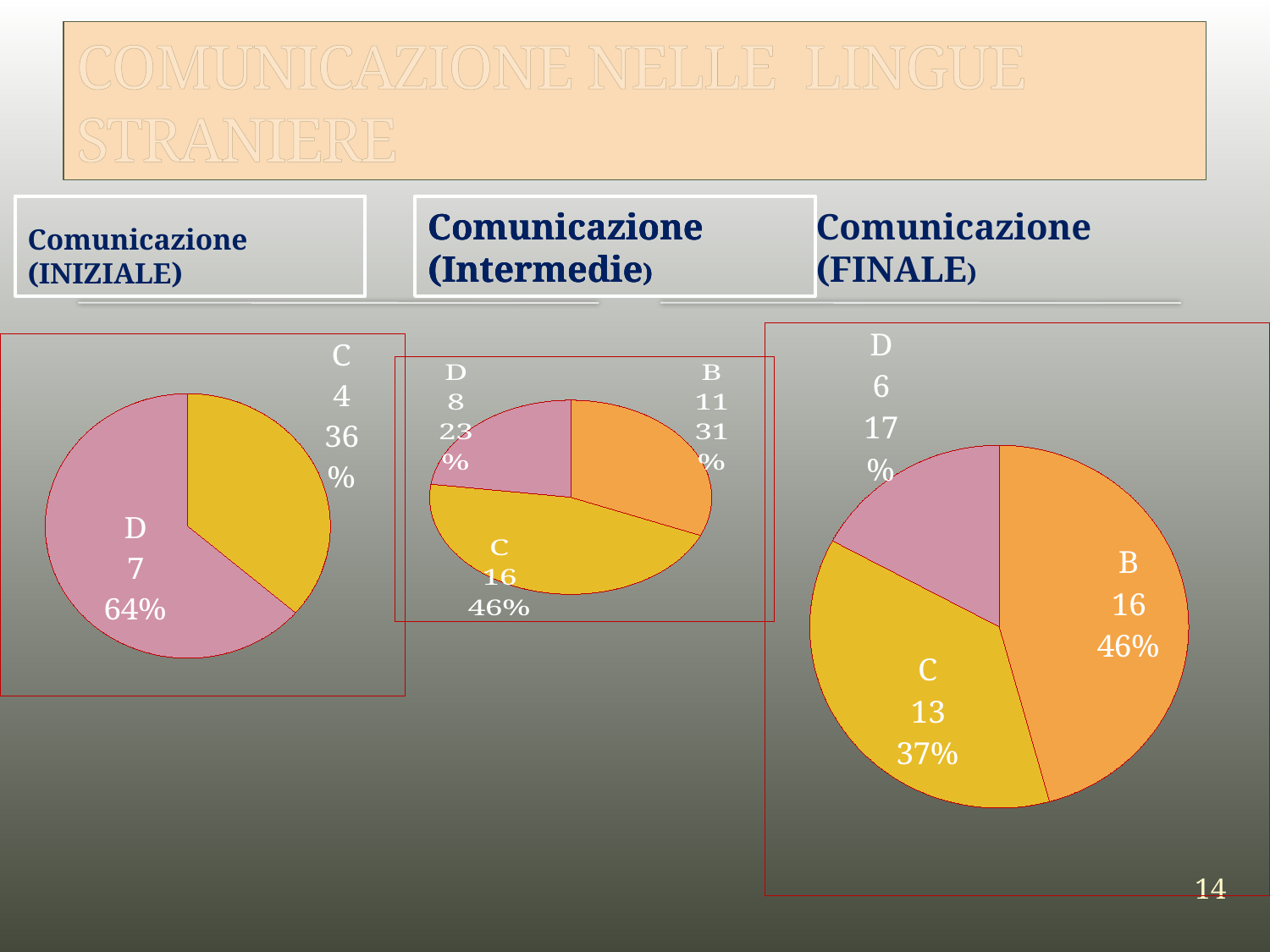
In the Comunicazione (INIZIALE) pie chart, how many slices are there? 2 In the Comunicazione (Intermedie) pie chart, what percentage share does category D have? 23% What type of chart is used for the Comunicazione (FINALE) data? Pie chart In the Comunicazione (FINALE) pie chart, what value is shown for category C? 13 In the Comunicazione (Intermedie) pie chart, what is the difference between the values for C and D? 8 In the Comunicazione (Intermedie) pie chart, which category has the largest slice? C In the Comunicazione (FINALE) pie chart, which category has the smallest slice? D In the Comunicazione (INIZIALE) pie chart, what value is shown for category D? 7 In the Comunicazione (INIZIALE) pie chart, what percentage share does category C have? 36% In the Comunicazione (Intermedie) pie chart, what value is shown for category B? 11 In the Comunicazione (FINALE) pie chart, which is larger, the value for B or the value for C? B In the Comunicazione (FINALE) pie chart, what percentage share does category B have? 46%